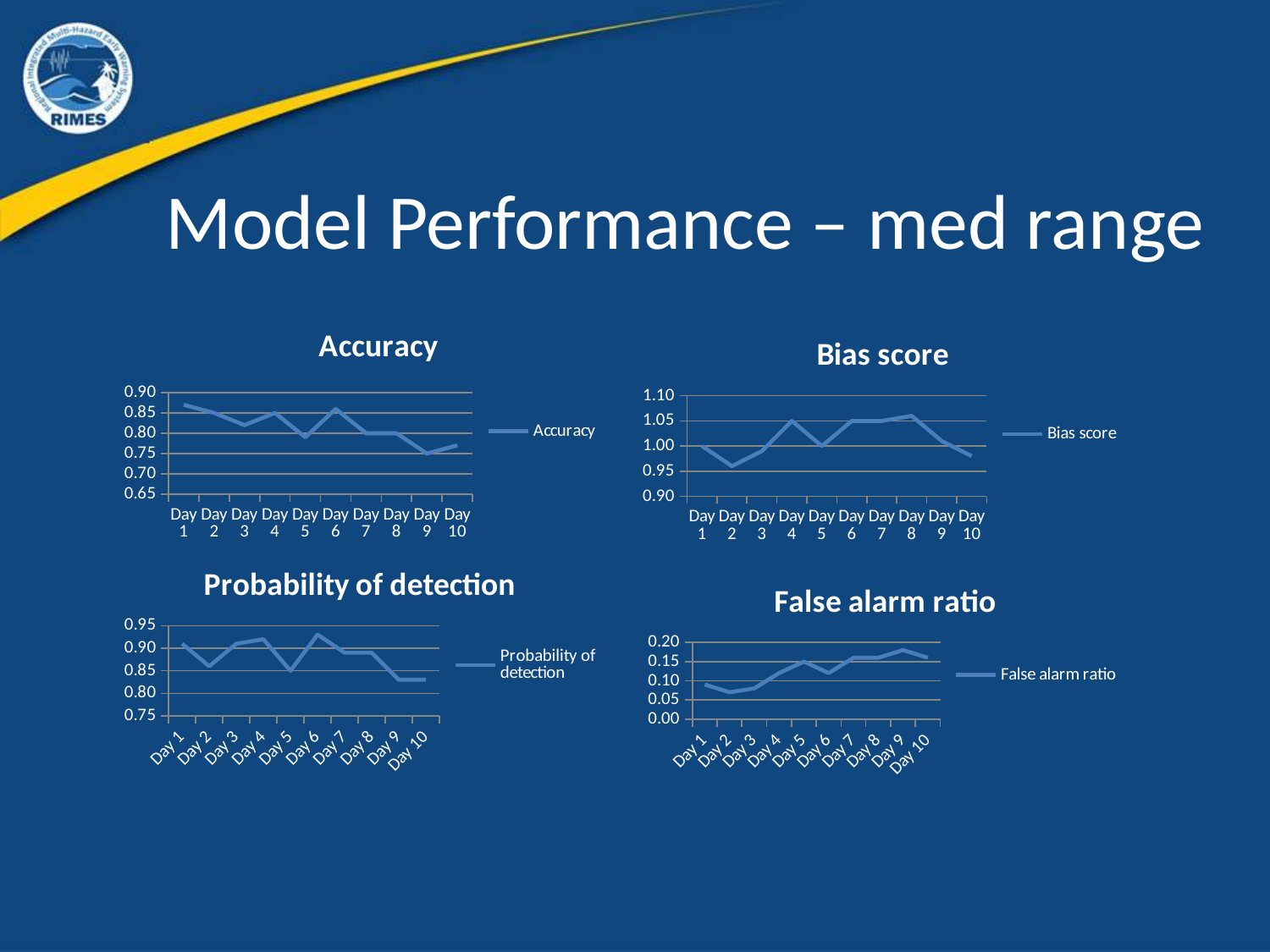
On the False alarm ratio chart, which day has the highest false alarm ratio? Day 9 On the False alarm ratio chart, do the values generally rise or fall from Day 1 to Day 10? rise How many days are plotted on the Bias score chart? 10 On the Probability of detection chart, is the value for Day 5 greater or less than 0.90? less On the Accuracy chart, is the value for Day 1 greater or less than 0.85? greater On the Bias score chart, which is larger, the value for Day 4 or the value for Day 5? Day 4 What kind of chart is the Accuracy chart? line chart On the Accuracy chart, which day has the lowest accuracy? Day 9 What is the title of the chart in the bottom-left of the slide? Probability of detection How many series does the legend of the False alarm ratio chart list? 1 On the Bias score chart, is the value for Day 10 greater or less than 1.00? less On the Bias score chart, which day has the lowest bias score? Day 2